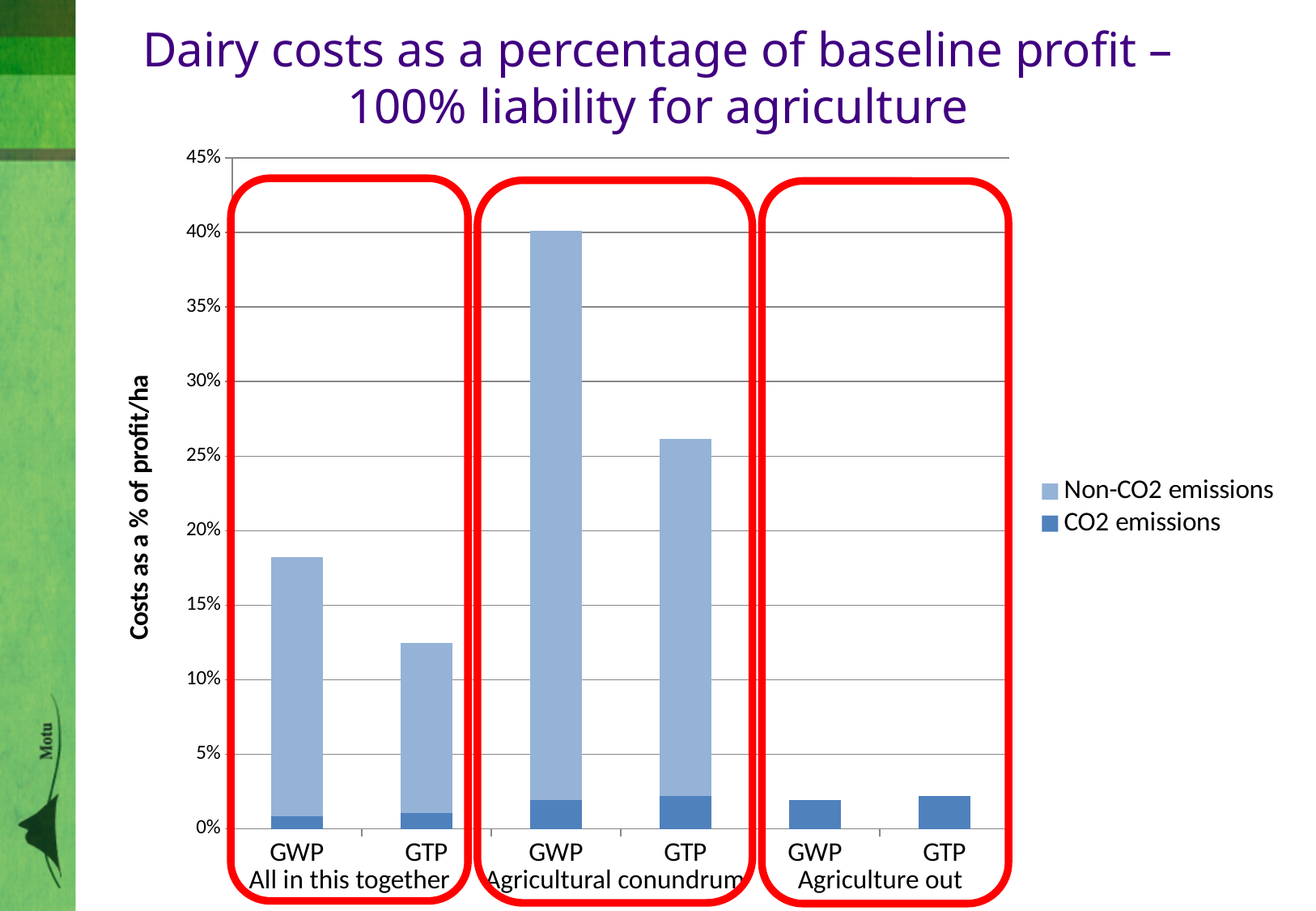
Is the total for GWP under Agricultural conundrum greater or less than 35%? greater Which is larger, the total for GWP or for GTP under All in this together? GWP How many bars are plotted in the chart? 6 What kind of chart is shown on the slide? stacked bar chart Which bar is the tallest in the chart? GWP under Agricultural conundrum Is the total for GTP under All in this together greater or less than 15%? less How many series does the legend list? 2 Is the total for GWP under Agriculture out greater or less than 5%? less Which series is shown in the lighter blue colour? Non-CO2 emissions What is the label on the vertical axis? Costs as a % of profit/ha